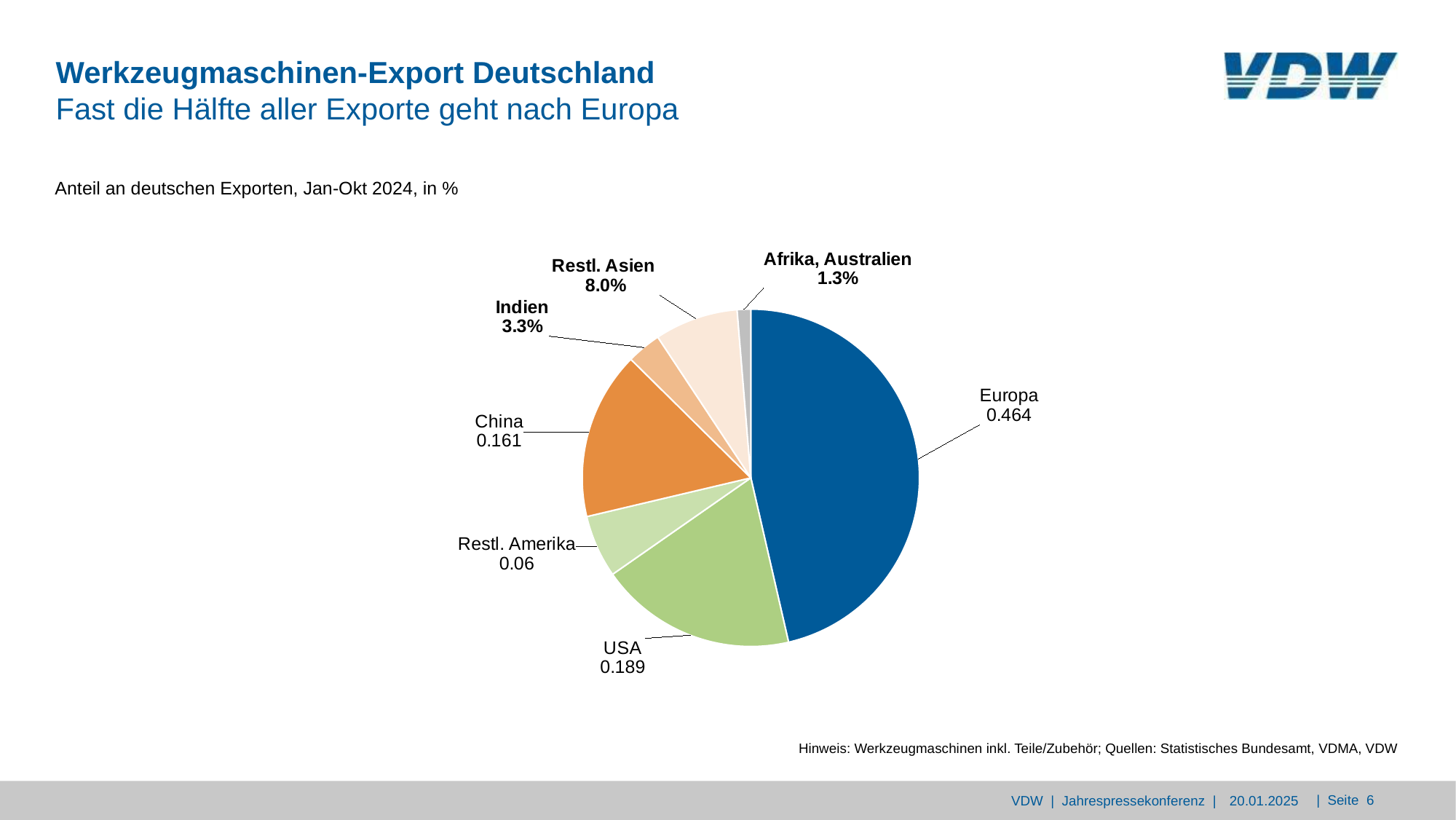
Which region has the smallest slice of the pie? Afrika, Australien What share is shown for Indien? 3.3% What is the value shown for Restl. Amerika? 0.06 How many slices does the pie chart have? 7 What share is shown for Restl. Asien? 8.0% What is the value shown for China? 0.161 What is the value shown for USA? 0.189 What share is shown for Afrika, Australien? 1.3% Which region has the largest slice of the pie? Europa Which is larger, the slice for USA or the slice for China? USA What is the value shown for Europa? 0.464 What kind of chart is shown on the slide? pie chart